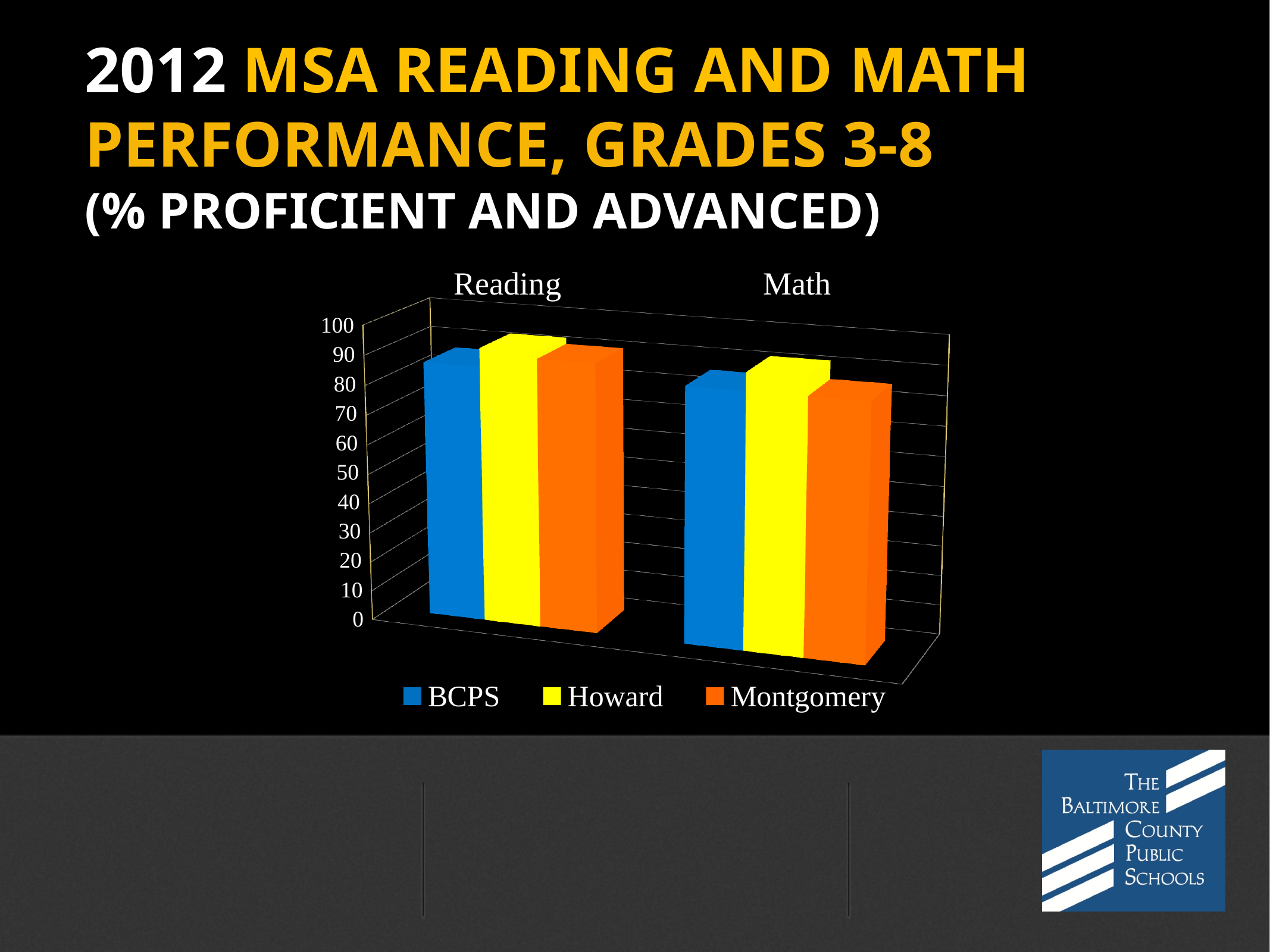
What kind of chart is shown on the slide? bar chart Which series has the highest value for Reading? Howard Is the value for Montgomery in Math greater or less than 90? less Is the BCPS value larger for Reading or for Math? Reading Which series is shown in yellow in the legend? Howard How many series does the legend list? 3 Is the Montgomery value larger for Reading or for Math? Reading Is the value for BCPS in Math greater or less than 70? greater Which series has the highest value for Math? Howard Is the value for Howard in Reading greater or less than 80? greater How many categories are shown on the x axis? 2